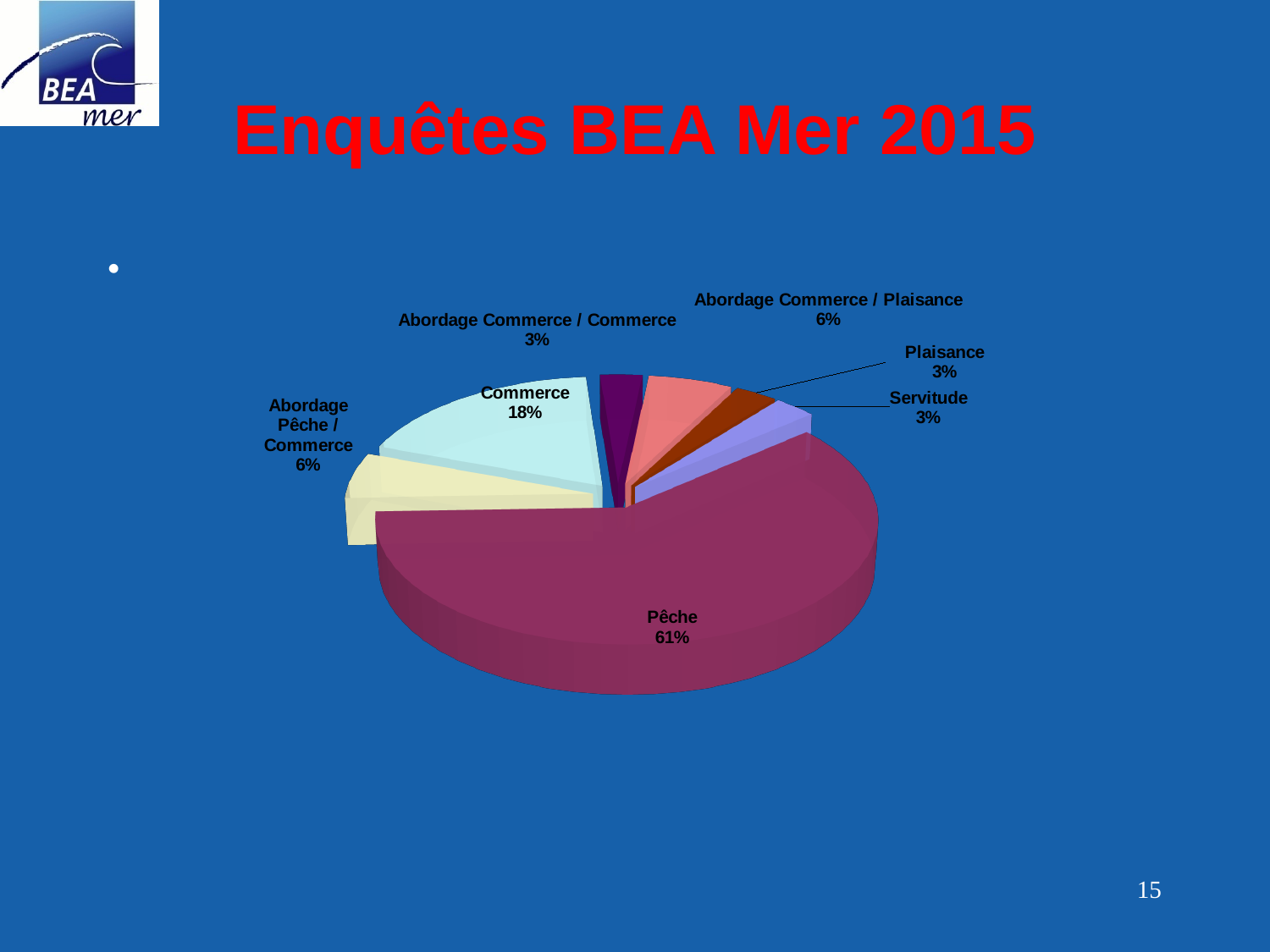
What is the combined share of Abordage Commerce / Plaisance and Abordage Pêche / Commerce? 12% What percentage is shown for Servitude? 3% What is the title of the slide containing the pie chart? Enquêtes BEA Mer 2015 What kind of chart is shown on the slide? pie chart Which is larger, the share for Commerce or the share for Plaisance? Commerce What share of the pie does Pêche represent? 61% What percentage is shown for Abordage Pêche / Commerce? 6% Which category has the largest slice of the pie? Pêche What share of the pie does Commerce represent? 18% What is the difference in percentage points between Pêche and Commerce? 43 What percentage is shown for Abordage Commerce / Plaisance? 6% How many slices does the pie chart have? 7